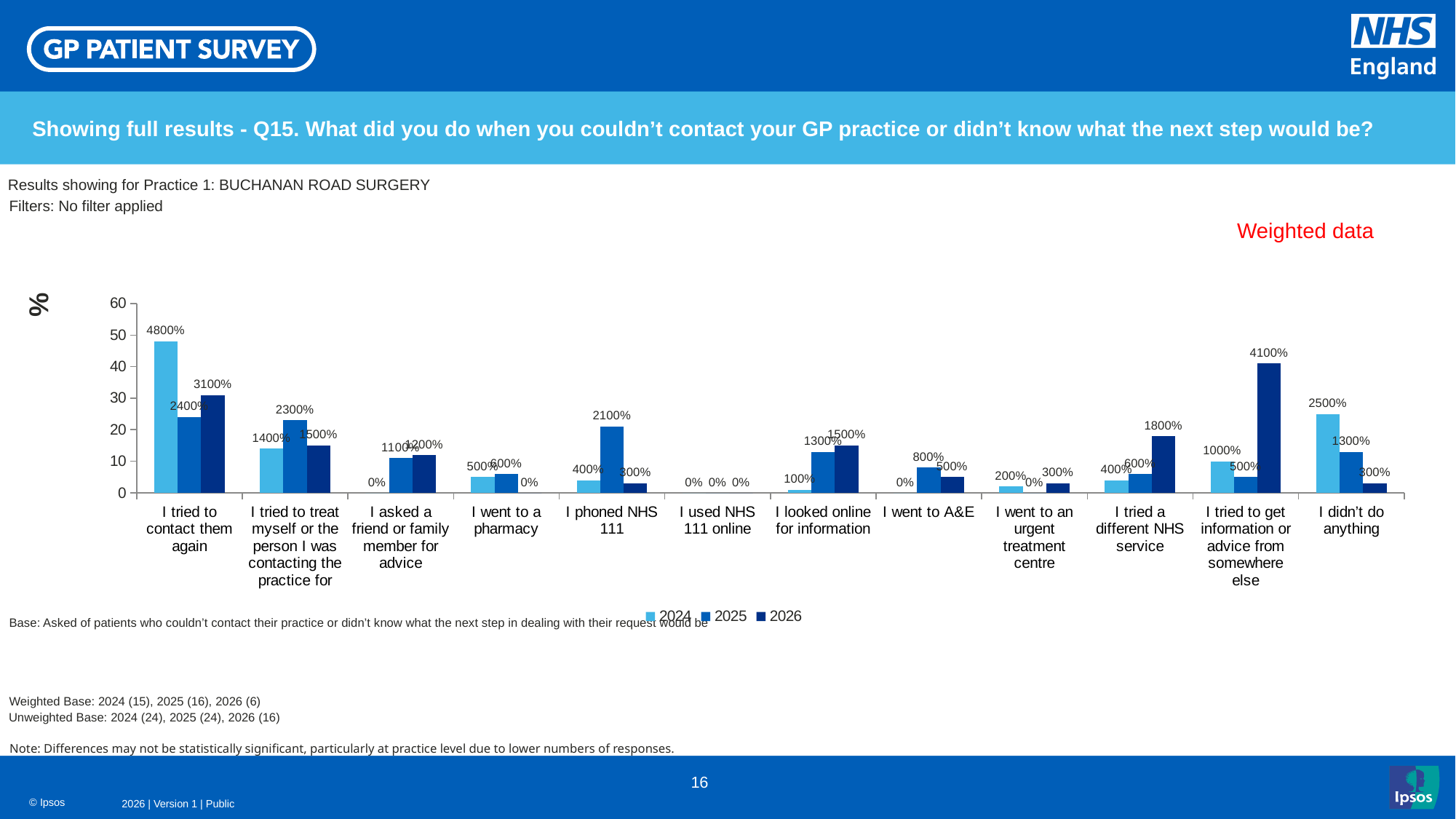
What is the 2025 value for 'I phoned NHS 111'? 2100% What is the difference between the 2024 and 2026 values for 'I tried to contact them again'? 1700% Which category has the highest 2026 value? I tried to get information or advice from somewhere else What kind of chart is shown on the slide? Bar chart Which category has the highest 2025 value? I tried to contact them again What is the 2024 value for 'I didn't do anything'? 2500% How many series does the legend list? 3 How many categories are shown on the x axis? 12 Which category has the highest 2024 value? I tried to contact them again Which is larger: the 2026 value for 'I tried a different NHS service' or the 2026 value for 'I looked online for information'? I tried a different NHS service What is the 2024 value for 'I tried to contact them again'? 4800% What is the 2026 value for 'I tried to get information or advice from somewhere else'? 4100%